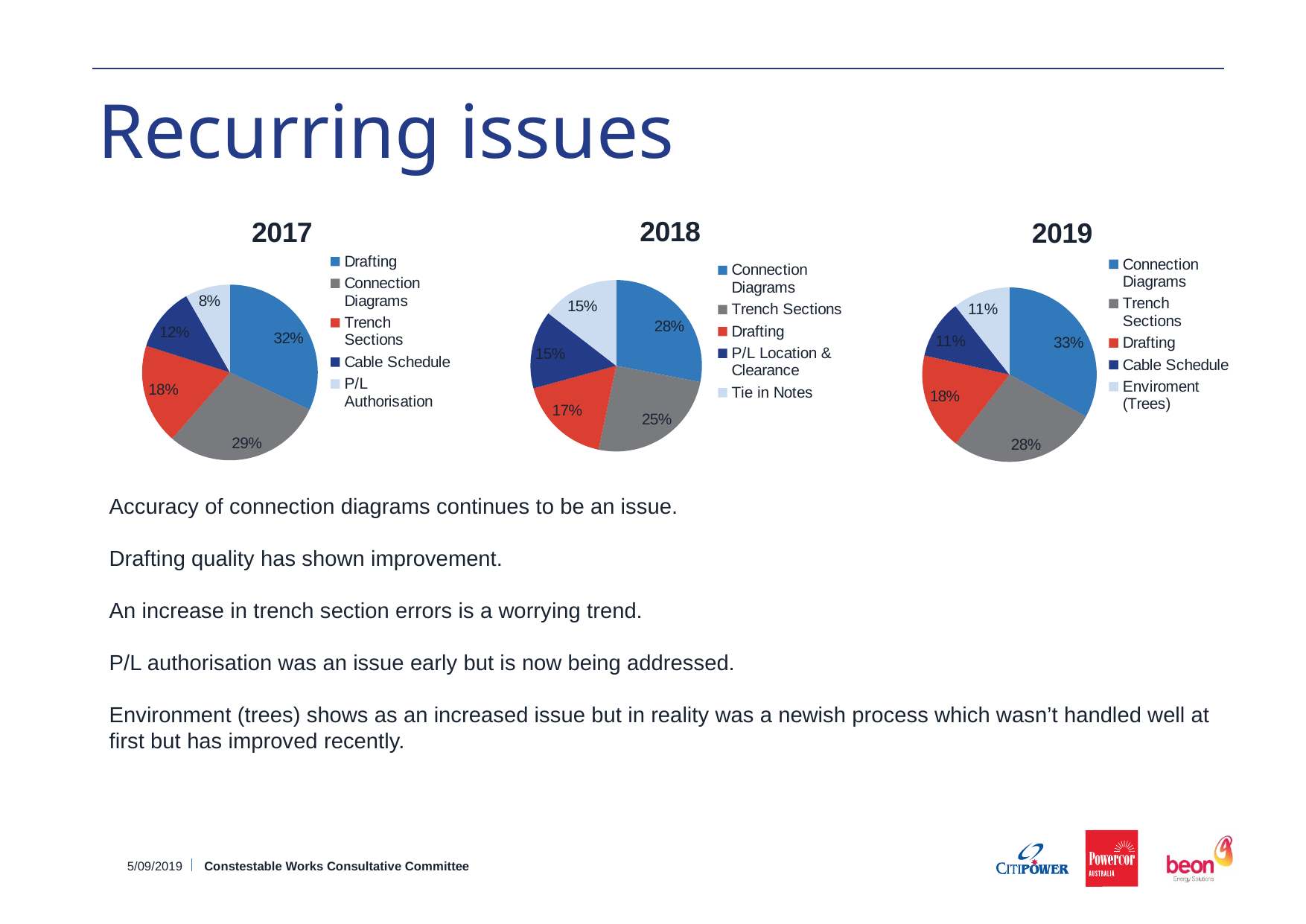
How many pie charts are shown on the slide? 3 In the 2017 chart, which category has the smallest share? P/L Authorisation In the 2018 chart, how many categories does the legend list? 5 In the 2019 chart, which category is shown in the lightest blue colour? Enviroment (Trees) In the 2017 chart, what is the difference between the Connection Diagrams share and the Cable Schedule share? 17% In the 2018 chart, which category has the largest share? Connection Diagrams In the 2019 chart, what share does Connection Diagrams have? 33% What kind of chart is used for the 2017, 2018 and 2019 data? Pie chart In the 2019 chart, which is larger, Trench Sections or Drafting? Trench Sections In the 2018 chart, what share does Trench Sections have? 25% In the 2019 chart, what is the difference between the Connection Diagrams share and the Drafting share? 15% In the 2017 chart, what share does Drafting have? 32%